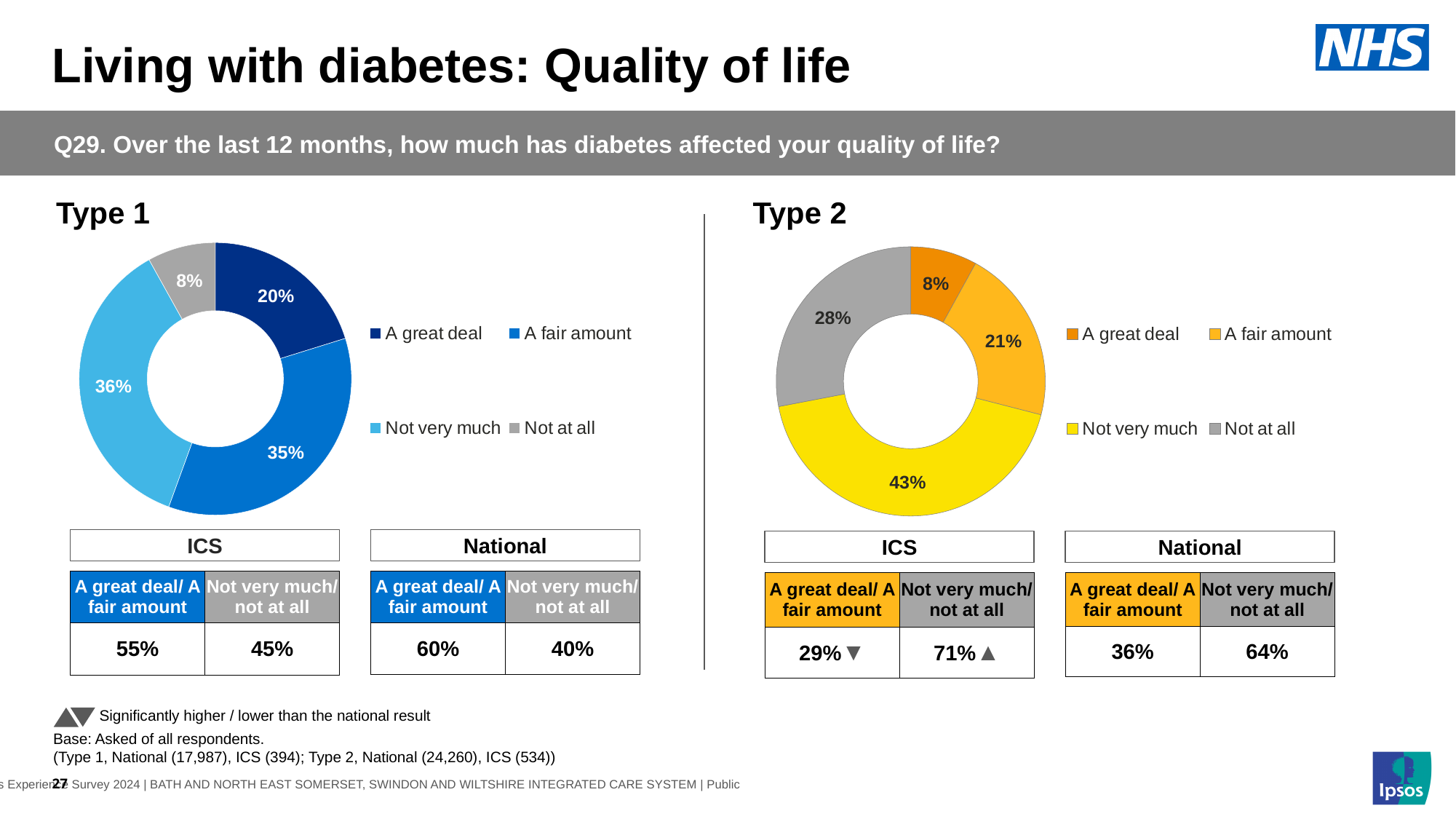
In the Type 2 chart, what is the difference between 'Not very much' and 'Not at all'? 15% What kind of chart is used for Type 1? Donut (pie) chart In the Type 2 chart, what is the value for 'Not at all'? 28% In the Type 1 chart, what is the difference between 'A fair amount' and 'A great deal'? 15% In the Type 1 chart, what is the value for 'Not very much'? 36% In the Type 2 chart, what is the value for 'A fair amount'? 21% In the Type 2 chart, which category has the smallest share? A great deal Which is larger in the Type 1 chart: 'A great deal' or 'Not at all'? A great deal In the Type 1 chart, what percentage of respondents said diabetes affected their quality of life 'A great deal'? 20% How many categories does the Type 2 chart show? 4 In the Type 2 chart, which category has the largest share? Not very much In the Type 1 chart, which category has the smallest share? Not at all